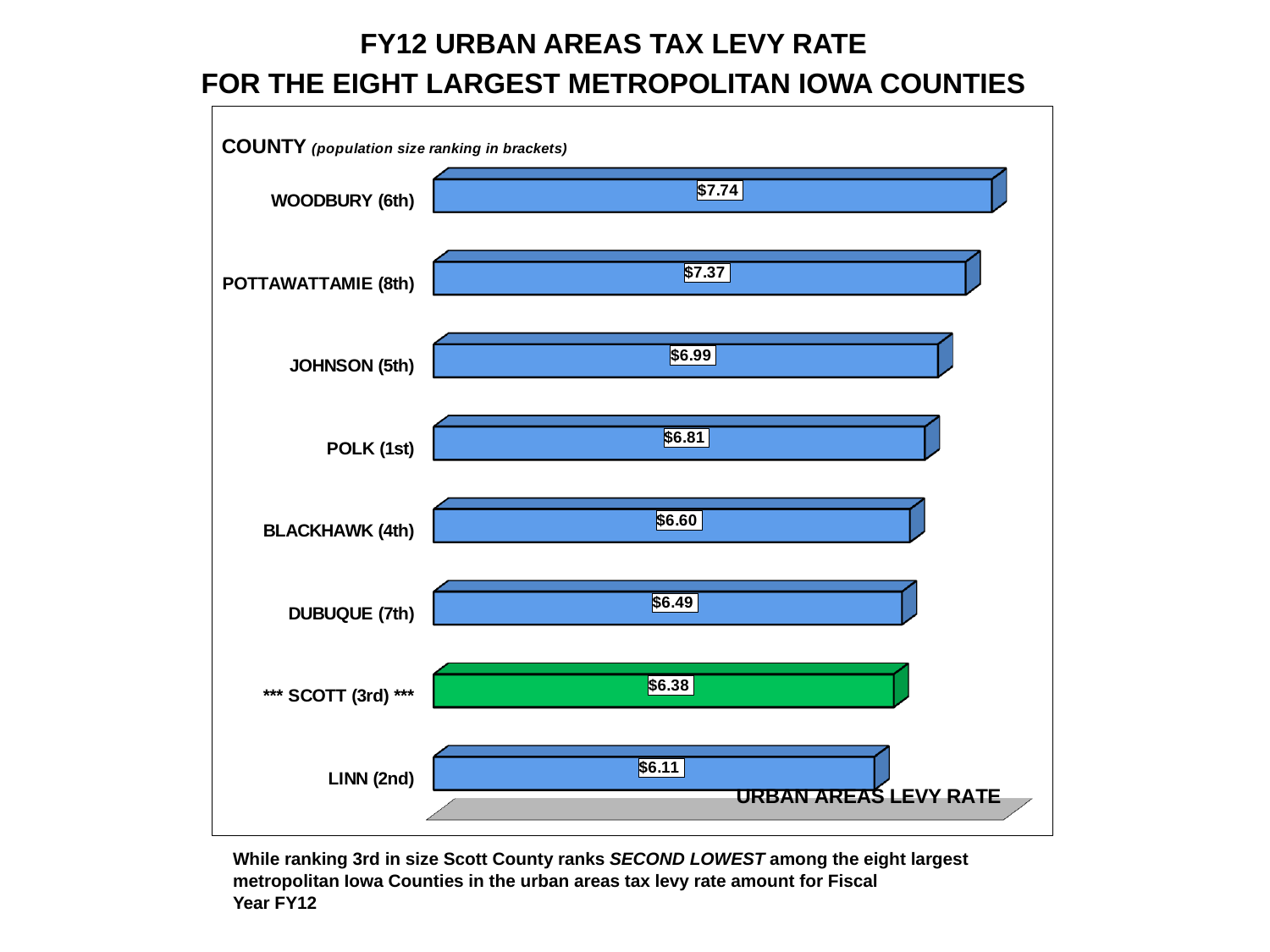
What is the difference between the levy rates of Johnson (5th) and Scott (3rd)? $0.61 What is the difference between the levy rates of Woodbury (6th) and Linn (2nd)? $1.63 Which county has the highest urban areas tax levy rate? Woodbury (6th) What is the urban areas tax levy rate for Polk (1st)? $6.81 How many counties are shown in the chart? 8 Which has a higher levy rate, Pottawattamie (8th) or Blackhawk (4th)? Pottawattamie (8th) Which county's bar is coloured green instead of blue? Scott (3rd) What is the urban areas tax levy rate for Woodbury (6th)? $7.74 What is the urban areas tax levy rate for Scott (3rd)? $6.38 What type of chart is shown on the slide? Bar chart Which county has the lowest urban areas tax levy rate? Linn (2nd) Which has a higher levy rate, Dubuque (7th) or Scott (3rd)? Dubuque (7th)